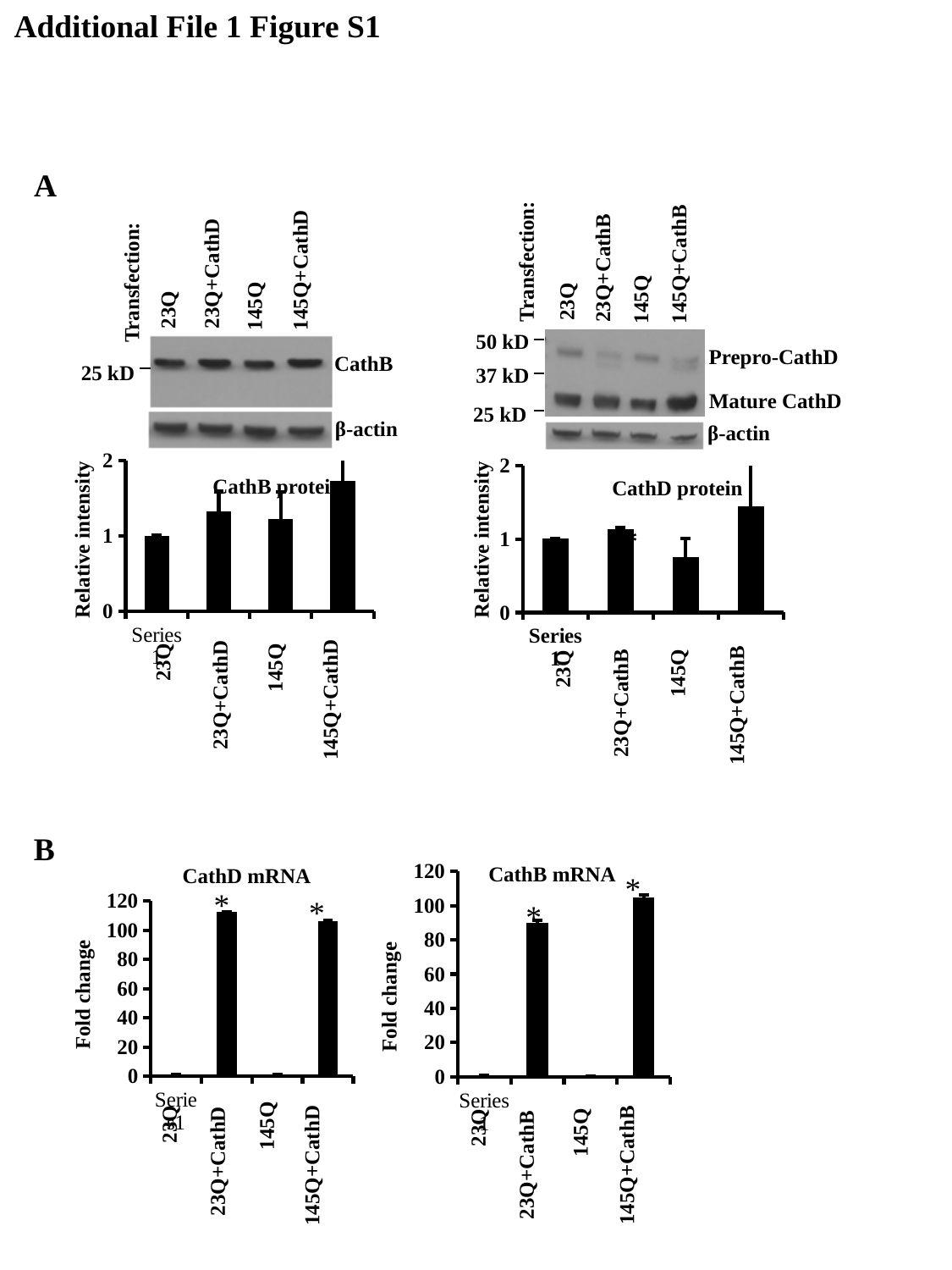
In the CathB protein chart, which category has the lowest relative intensity? 23Q What is the y-axis label of the CathD mRNA chart? Fold change In the CathD protein chart, which category has the highest relative intensity? 145Q+CathB In the CathD protein chart, is the value for 145Q greater or less than 1? less In the CathB mRNA chart, which category has the highest fold change? 145Q+CathB In the CathD protein chart, which category has the lowest relative intensity? 145Q In the CathB mRNA chart, which is larger, the value for 23Q+CathB or the value for 145Q+CathB? 145Q+CathB What kind of chart is the CathB mRNA chart? bar chart In the CathD mRNA chart, is the value for 23Q+CathD greater or less than 100? greater In the CathB protein chart, which category has the highest relative intensity? 145Q+CathD How many categories are shown on the x axis of the CathD mRNA chart? 4 In the CathB mRNA chart, is the value for 23Q+CathB greater or less than 100? less